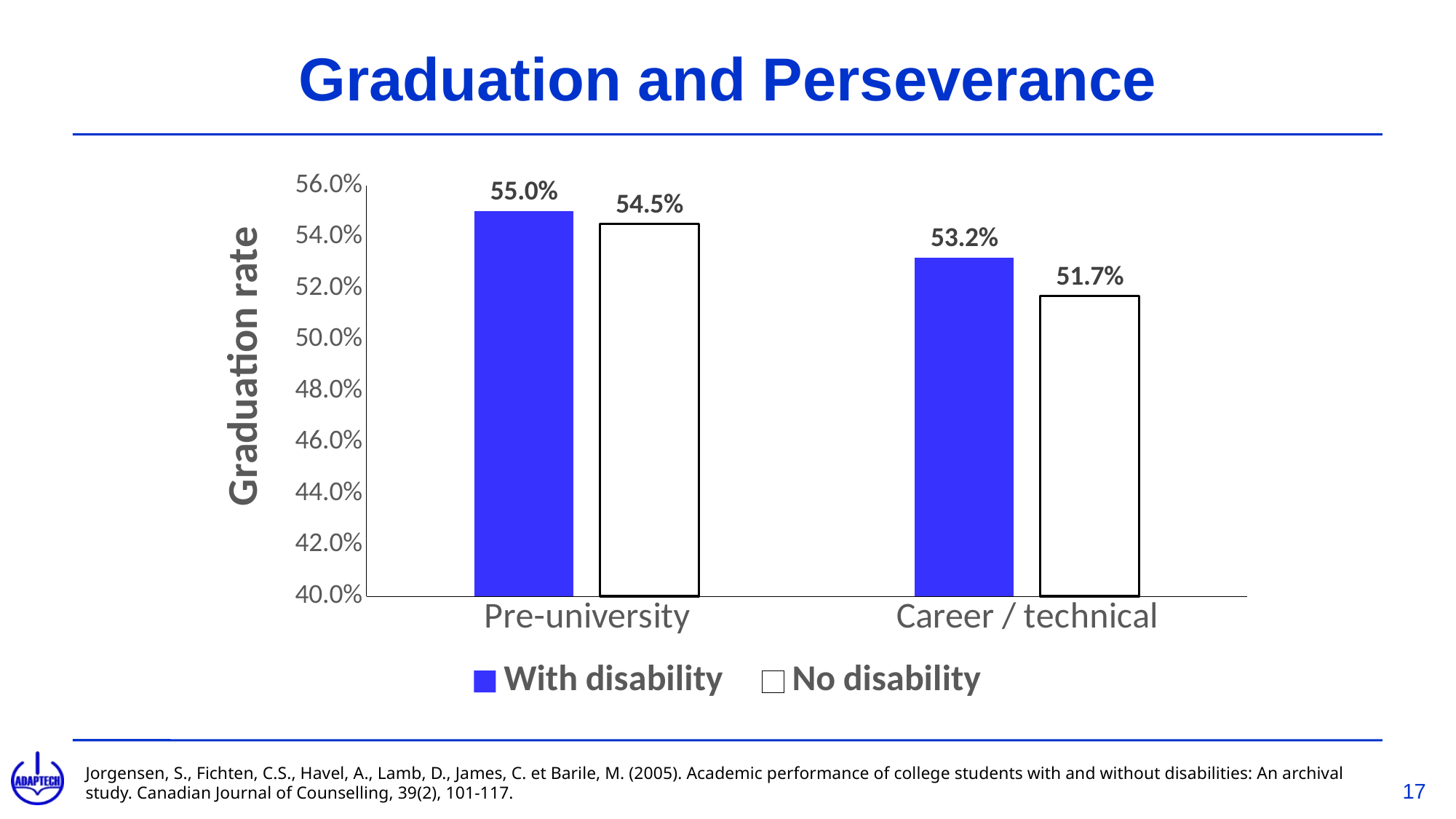
What kind of chart is shown on the slide? Bar chart Which category and series has the highest graduation rate? Pre-university, With disability How many series does the legend list? 2 What is the graduation rate for students with disability in the Career / technical category? 53.2% Which category and series has the lowest graduation rate? Career / technical, No disability What is the graduation rate for students with no disability in the Pre-university category? 54.5% What is the graduation rate for students with disability in the Pre-university category? 55.0% Which is larger: the No disability graduation rate for Pre-university or the With disability graduation rate for Career / technical? No disability for Pre-university How many categories are shown on the x axis? 2 What is the difference between the With disability and No disability graduation rates in the Pre-university category? 0.5% What is the difference between the With disability and No disability graduation rates in the Career / technical category? 1.5% What is the graduation rate for students with no disability in the Career / technical category? 51.7%